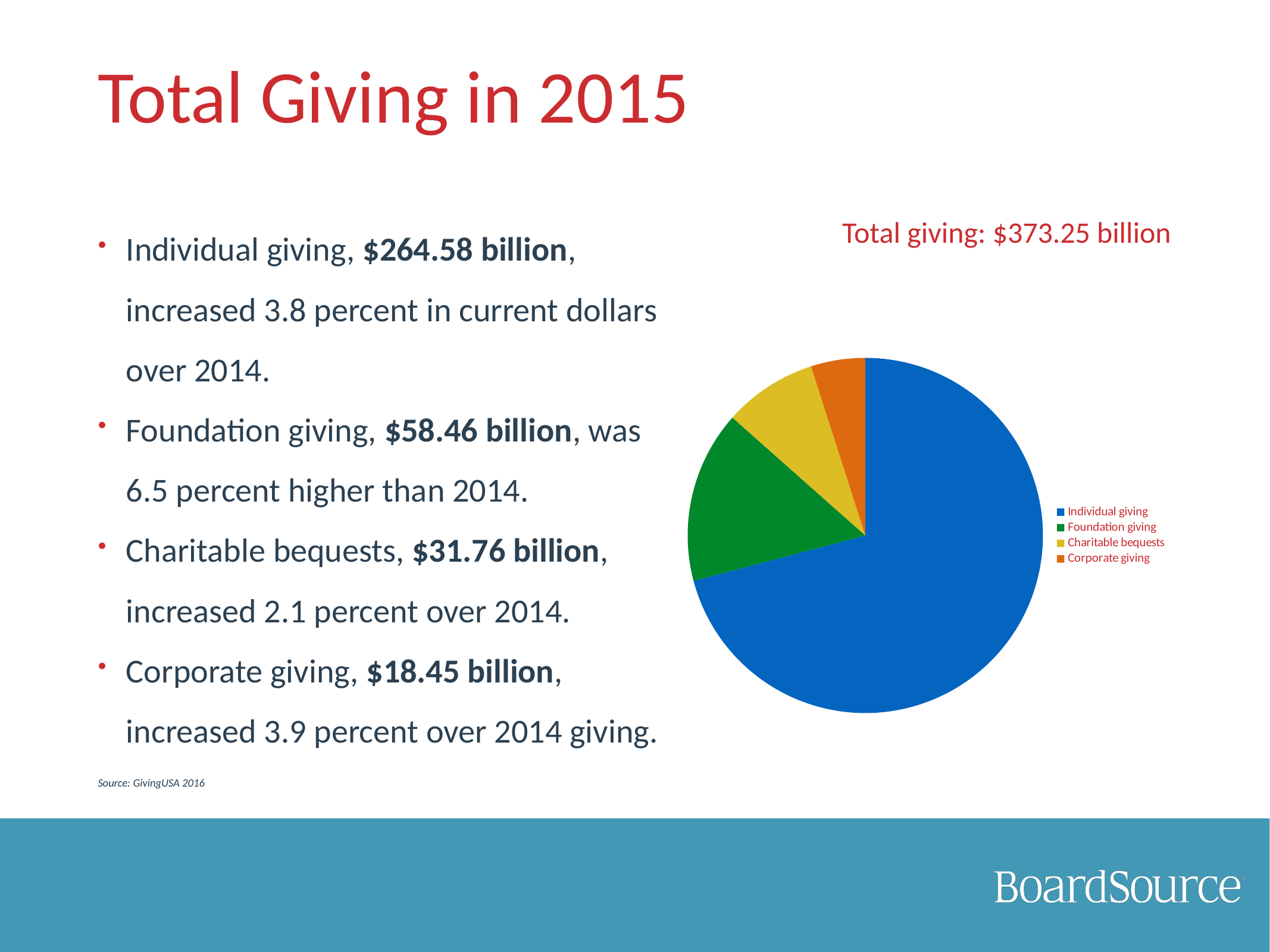
What type of chart is shown on the slide? pie chart How many slices does the pie chart have? 4 How many entries does the pie chart's legend list? 4 What is the value for Individual giving shown on the slide? $264.58 billion What is the value for Charitable bequests shown on the slide? $31.76 billion Which is larger, Foundation giving or Charitable bequests? Foundation giving What is the total giving shown above the pie chart? $373.25 billion What is the value for Corporate giving shown on the slide? $18.45 billion What is the difference between Foundation giving and Charitable bequests? $26.70 billion Which category has the smallest slice of the pie chart? Corporate giving Which category has the largest slice of the pie chart? Individual giving What is the value for Foundation giving shown on the slide? $58.46 billion